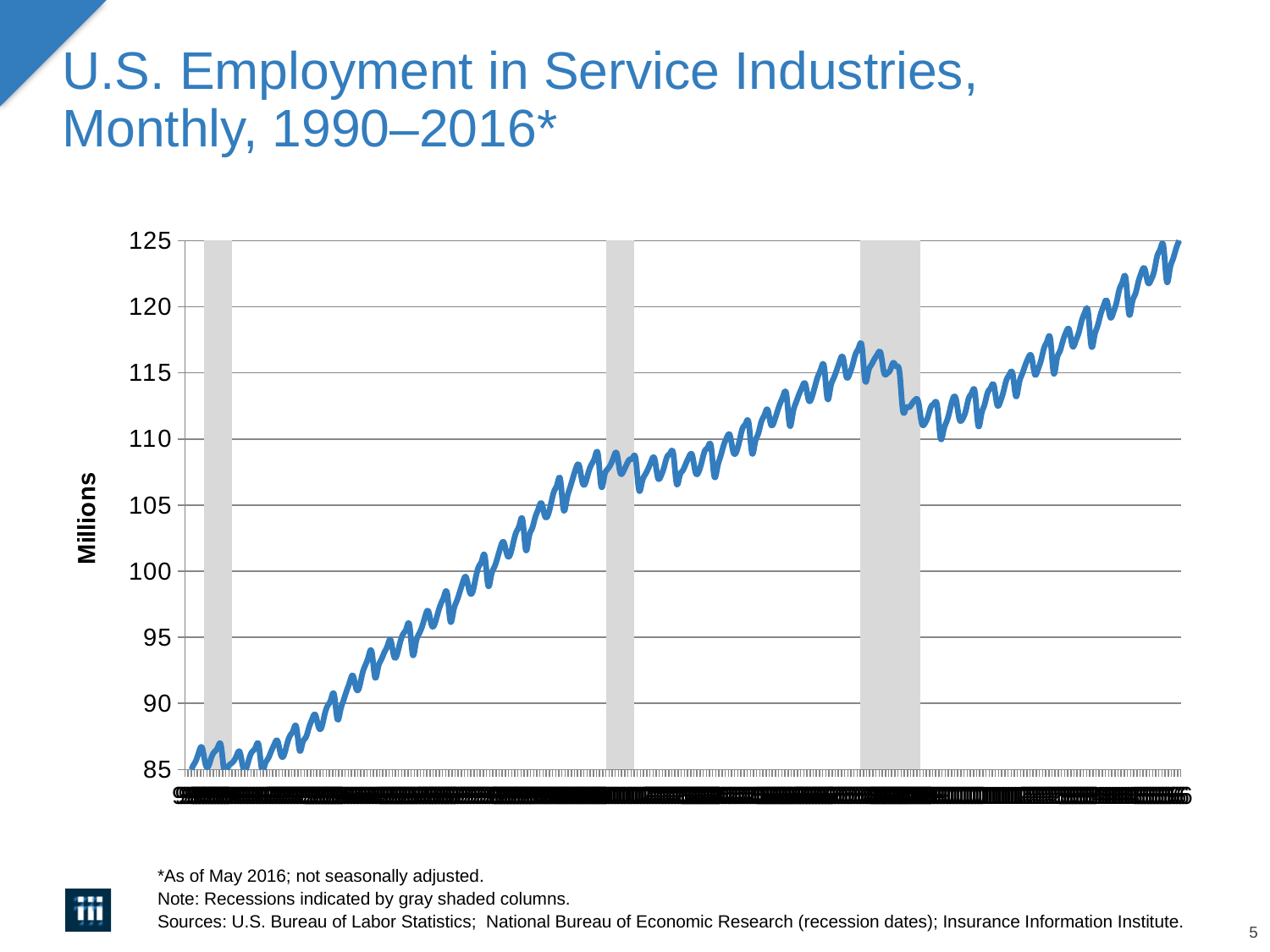
How many gray shaded recession columns are shown on the chart? 3 Is the value at the left end of the line (the earliest month) greater or less than 90? less Do the values generally rise or fall from left to right along the x axis? rise What kind of chart is shown on the slide? line chart Is the value at the right end of the line (the most recent month) greater or less than 120? greater Is the lowest point of the line greater or less than 90? less What is the label on the vertical axis? Millions